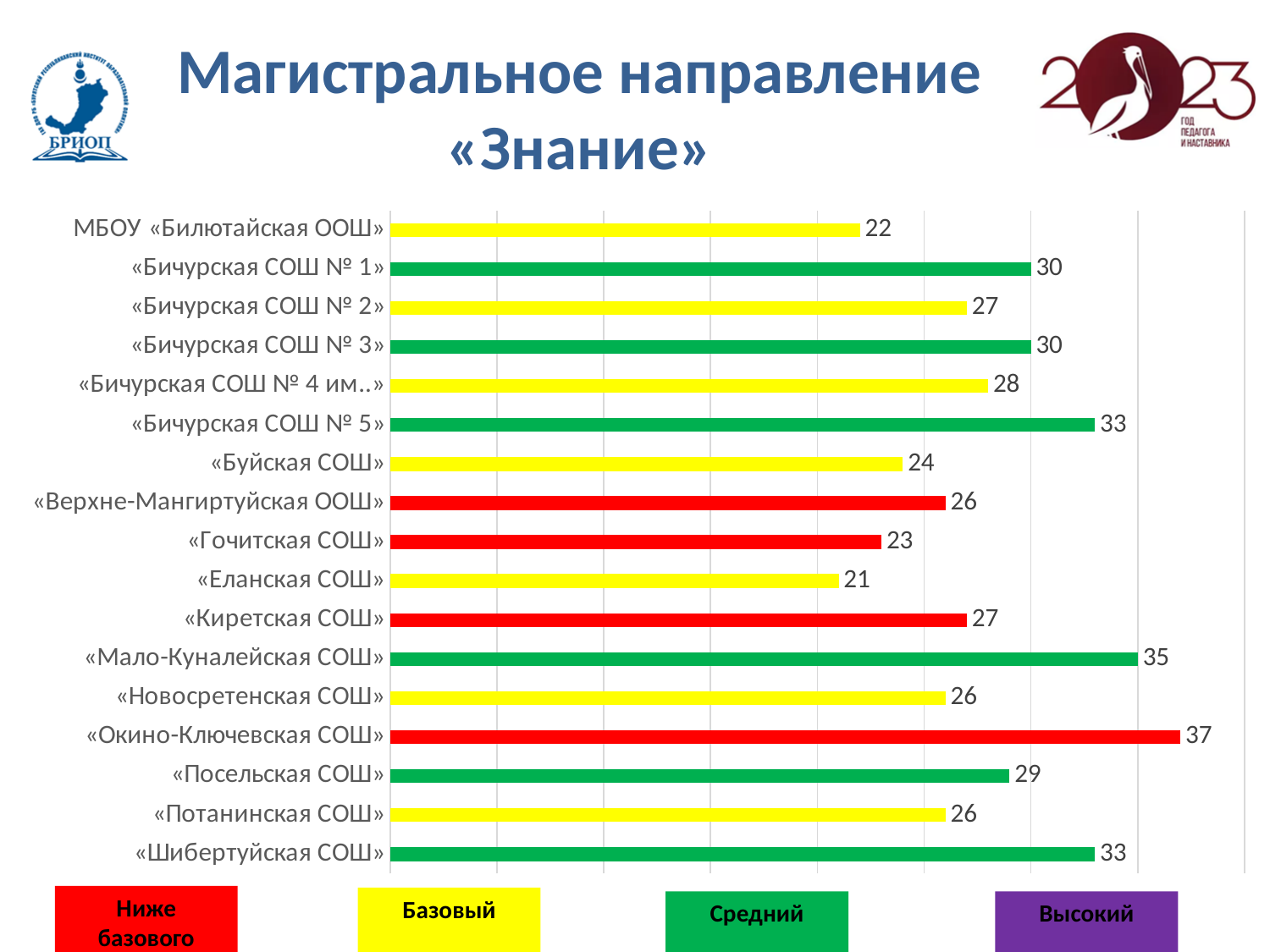
What is the value for «Бичурская СОШ № 5»? 33 Which is larger, the value for «Посельская СОШ» or the value for «Буйская СОШ»? «Посельская СОШ» What is the value for «Еланская СОШ»? 21 Which school has the lowest value? «Еланская СОШ» What is the value for «Мало-Куналейская СОШ»? 35 How many schools are shown in the chart? 17 Which school has the highest value? «Окино-Ключевская СОШ» What is the value for «Гочитская СОШ»? 23 What kind of chart is shown on the slide? Bar chart What colour is the bar for «Окино-Ключевская СОШ»? Red What is the difference between the values for «Бичурская СОШ № 1» and «Бичурская СОШ № 2»? 3 What is the difference between the values for «Окино-Ключевская СОШ» and «Еланская СОШ»? 16